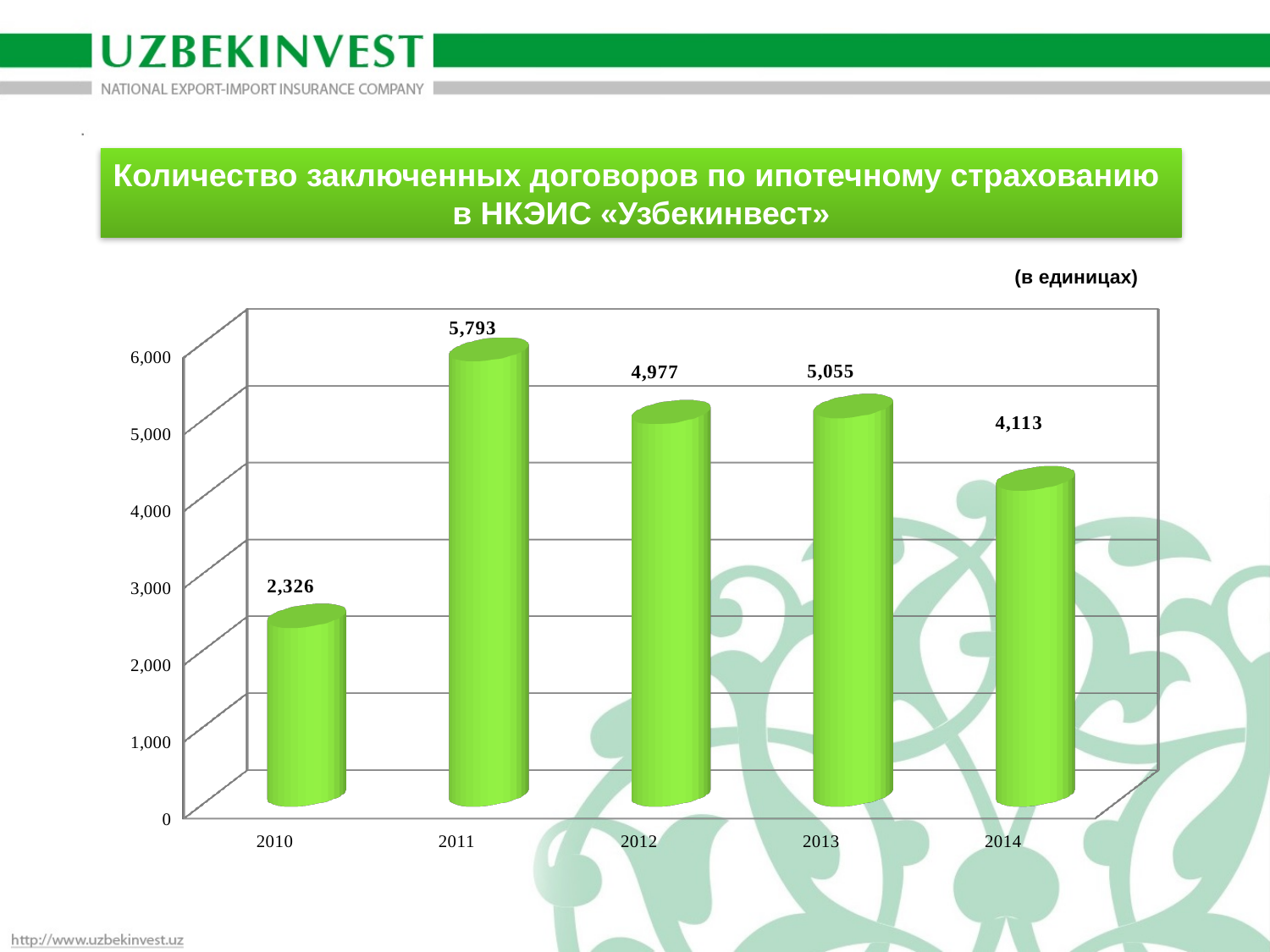
How many years are shown on the x axis? 5 Which year has the highest value? 2011 Is the value for 2014 greater or less than 5,000? less Do the values rise or fall from 2013 to 2014? fall What is the difference between the values for 2011 and 2010? 3,467 What is the value for 2011? 5,793 Which year has the lowest value? 2010 What is the value for 2014? 4,113 Which is larger, the value for 2012 or the value for 2014? 2012 What kind of chart is shown on the slide? bar chart What is the value for 2010? 2,326 What is the difference between the values for 2013 and 2012? 78